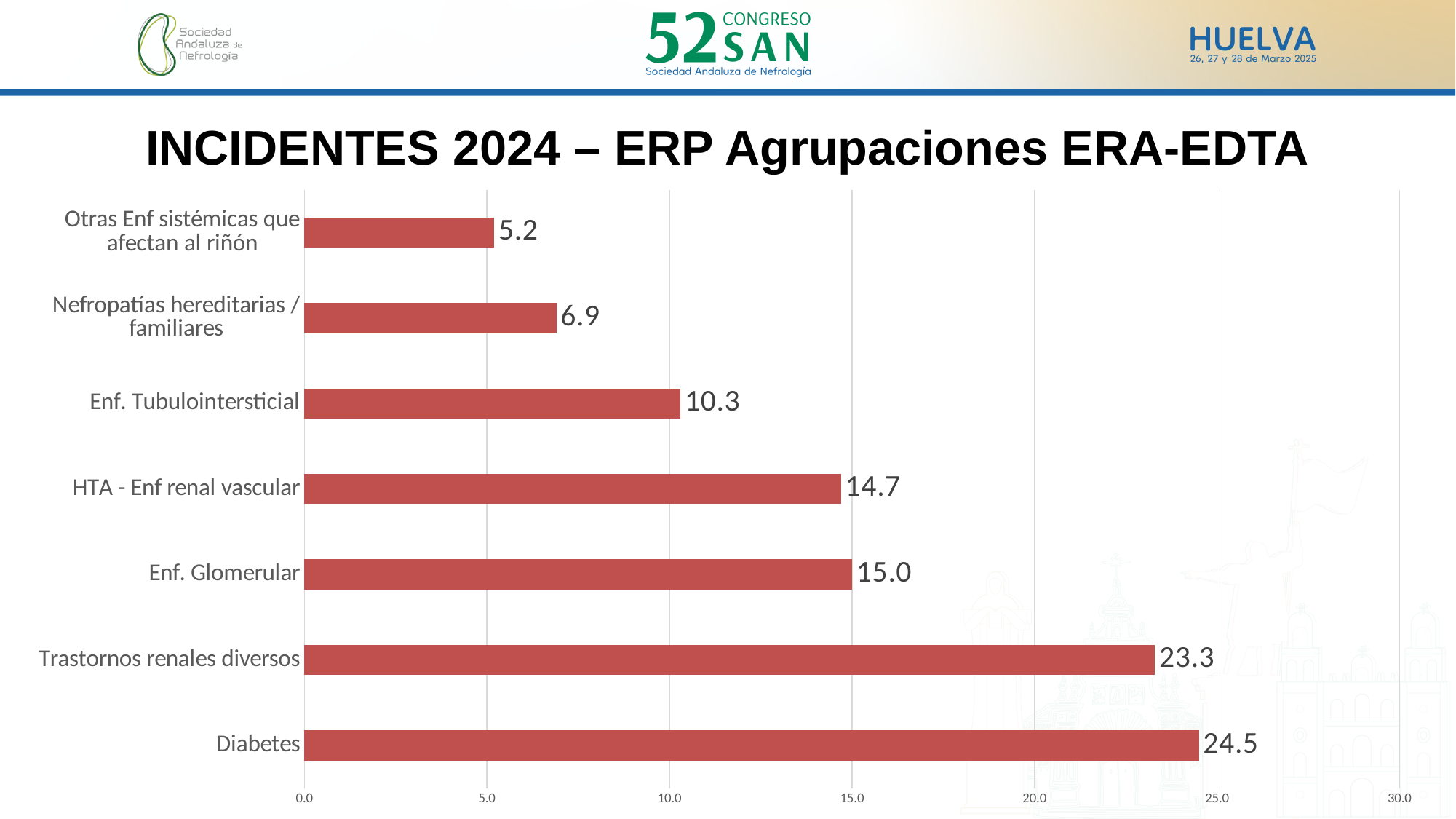
What is the value for Enf. Tubulointersticial? 10.3 What is the value for Nefropatías hereditarias / familiares? 6.9 What is the value for Diabetes? 24.5 How many categories are shown in the chart? 7 Which is larger, the value for HTA - Enf renal vascular or the value for Enf. Tubulointersticial? HTA - Enf renal vascular What is the title of the chart? INCIDENTES 2024 – ERP Agrupaciones ERA-EDTA Is the value for Trastornos renales diversos greater or less than 20.0? greater What is the difference between the values for Diabetes and Trastornos renales diversos? 1.2 Which category has the highest value? Diabetes What kind of chart is shown on the slide? Bar chart Which category has the lowest value? Otras Enf sistémicas que afectan al riñón What is the difference between the values for Enf. Glomerular and Enf. Tubulointersticial? 4.7